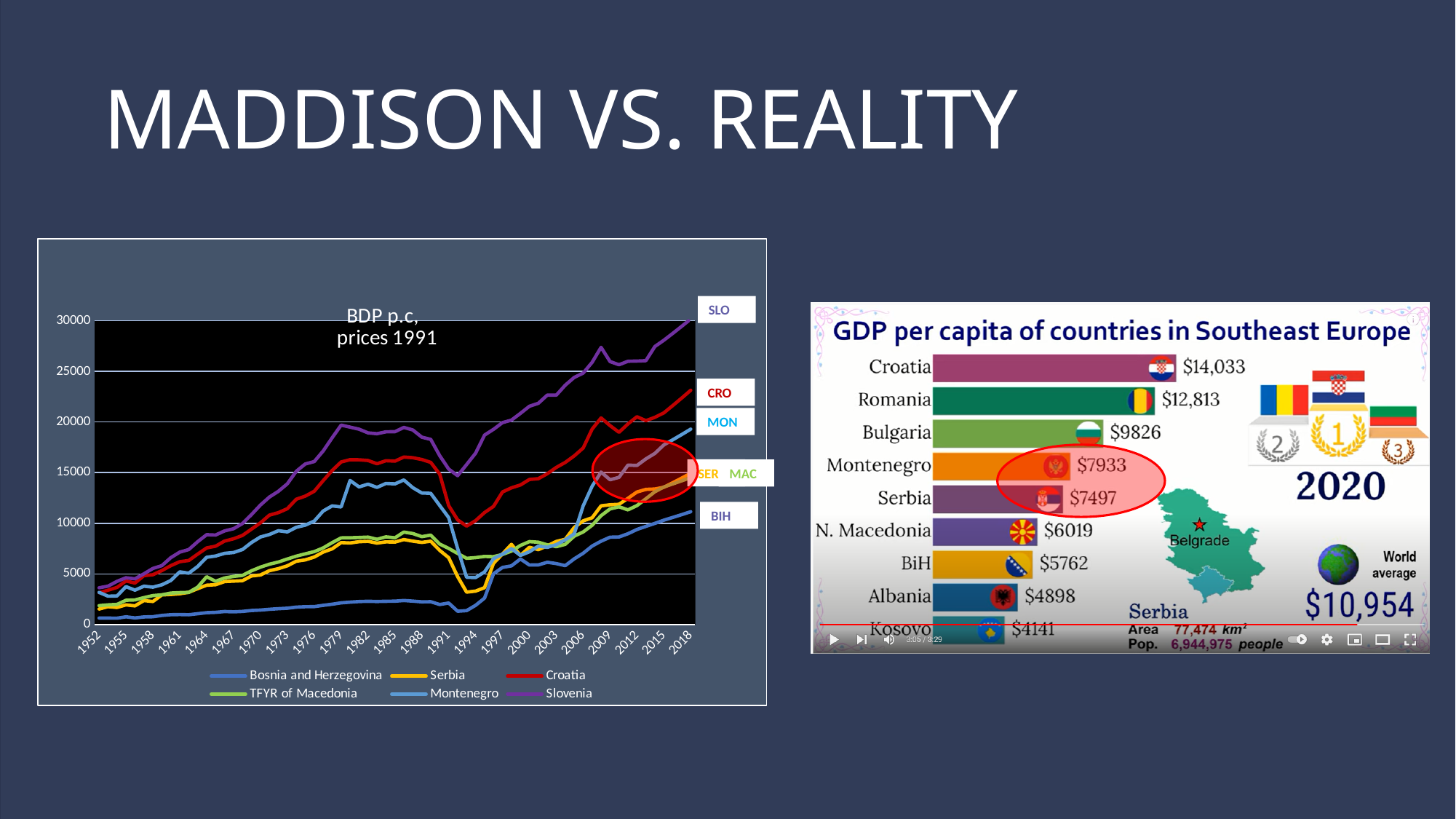
What kind of chart is the right chart 'GDP per capita of countries in Southeast Europe'? bar chart In the left chart 'BDP p.c, prices 1991', is the value for Slovenia in 2018 greater or less than 25000? greater In the left chart 'BDP p.c, prices 1991', is the value for Bosnia and Herzegovina in 2018 greater or less than 15000? less In the left chart 'BDP p.c, prices 1991', does the Slovenia line overall rise or fall from 1952 to 2018? rise In the left chart 'BDP p.c, prices 1991', which country has the highest value in 2018? Slovenia In the right chart 'GDP per capita of countries in Southeast Europe', which country has the highest GDP per capita? Croatia In the right chart 'GDP per capita of countries in Southeast Europe', what is the value for Serbia? $7497 How many countries are shown in the right chart 'GDP per capita of countries in Southeast Europe'? 9 What kind of chart is the left chart titled 'BDP p.c, prices 1991'? line chart How many series does the legend of the left chart 'BDP p.c, prices 1991' list? 6 In the left chart 'BDP p.c, prices 1991', which country has the lowest value in 2018? Bosnia and Herzegovina In the right chart 'GDP per capita of countries in Southeast Europe', what is the difference between Montenegro and Serbia? $436